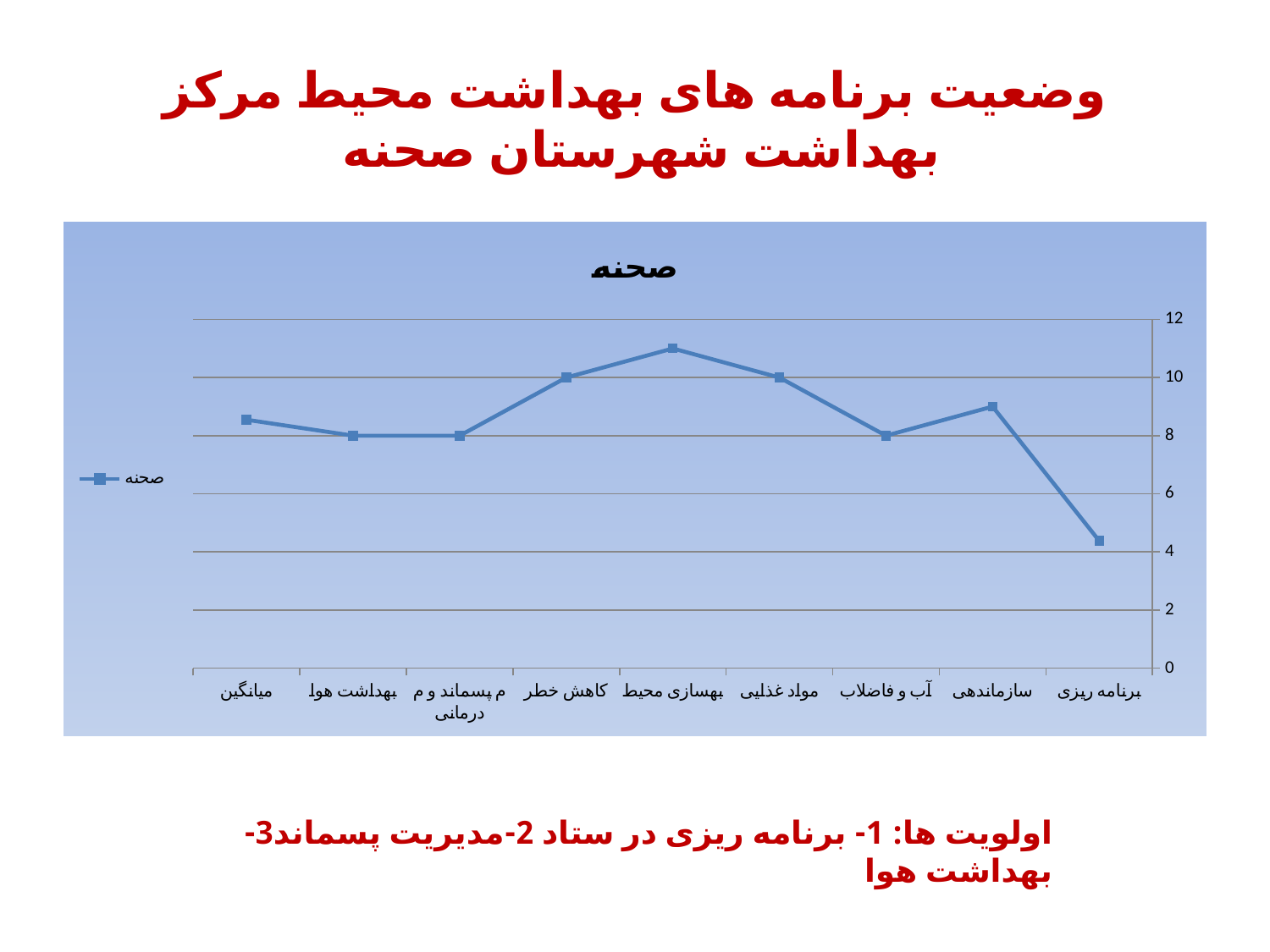
What is the title of the chart? صحنه What is the value for بهداشت هوا? 8 What is the value for آب و فاضلاب? 8 What is the difference between the values for کاهش خطر and بهداشت هوا? 2 How many series does the legend list? 1 Is the value for برنامه ریزی greater or less than 6? less What is the value for کاهش خطر? 10 Is the value for بهسازی محیط greater or less than 10? greater How many categories are plotted along the x axis? 9 What type of chart is shown on the slide? line chart Which category has the highest value? بهسازی محیط Which category has the lowest value? برنامه ریزی